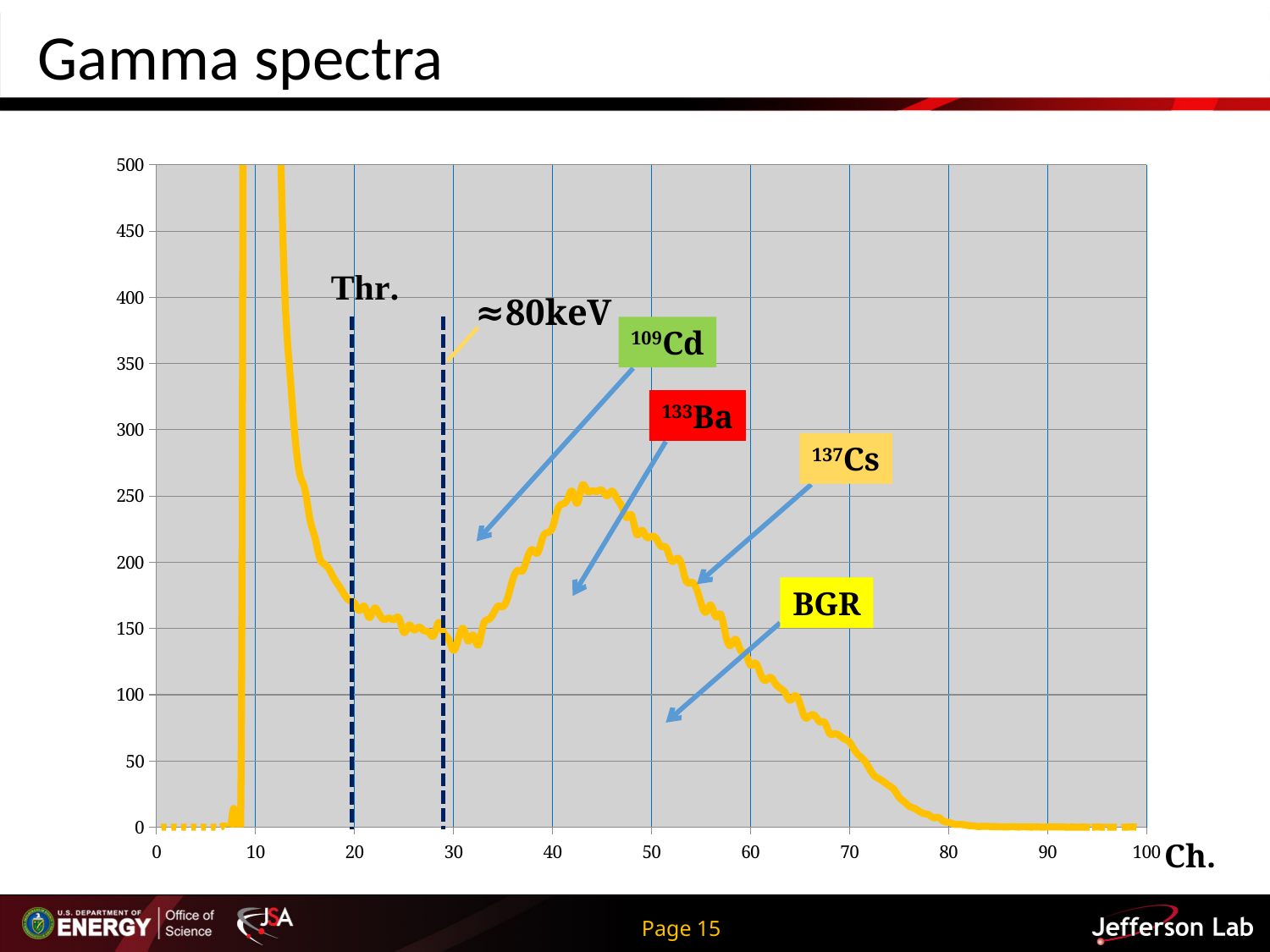
Do the spectrum values rise or fall as the channel increases from 30 to 43? rise Is the value of the spectrum at channel 40 greater or less than 200? greater Do the spectrum values rise or fall as the channel increases from 50 to 80? fall Which is larger, the spectrum value at channel 20 or at channel 30? channel 20 What label is shown on the x axis of the chart? Ch. Is the peak of the spectrum near channel 45 greater or less than 300? less What is the title of the slide containing the chart? Gamma spectra Is the value of the spectrum at channel 90 greater or less than 50? less What kind of chart is shown on the slide? line chart Which is larger, the spectrum value at channel 40 or at channel 70? channel 40